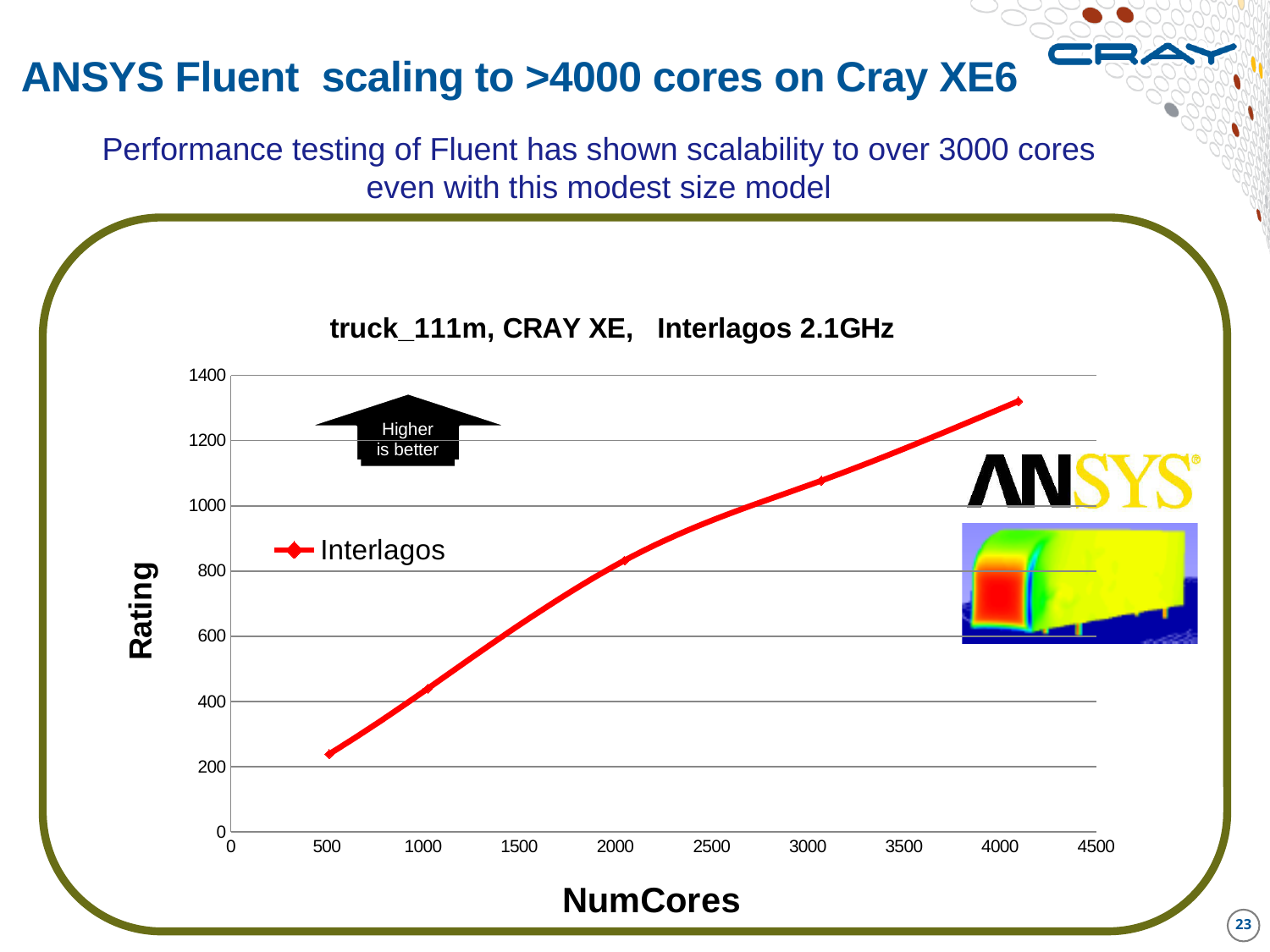
Is the Rating for the data point around 3000 cores greater or less than 1000? greater Is the Rating for the first data point (around 500 cores) greater or less than 400? less How many series does the chart's legend list? 1 How many data points are plotted on the Interlagos line? 5 Does the Rating rise or fall as NumCores increases along the x axis? rises What is the title of the chart? truck_111m, CRAY XE, Interlagos 2.1GHz Is the Rating for the data point around 2000 cores greater or less than 1000? less What are the labels of the x axis and the y axis of the chart? NumCores and Rating What kind of chart is shown on the slide? line chart